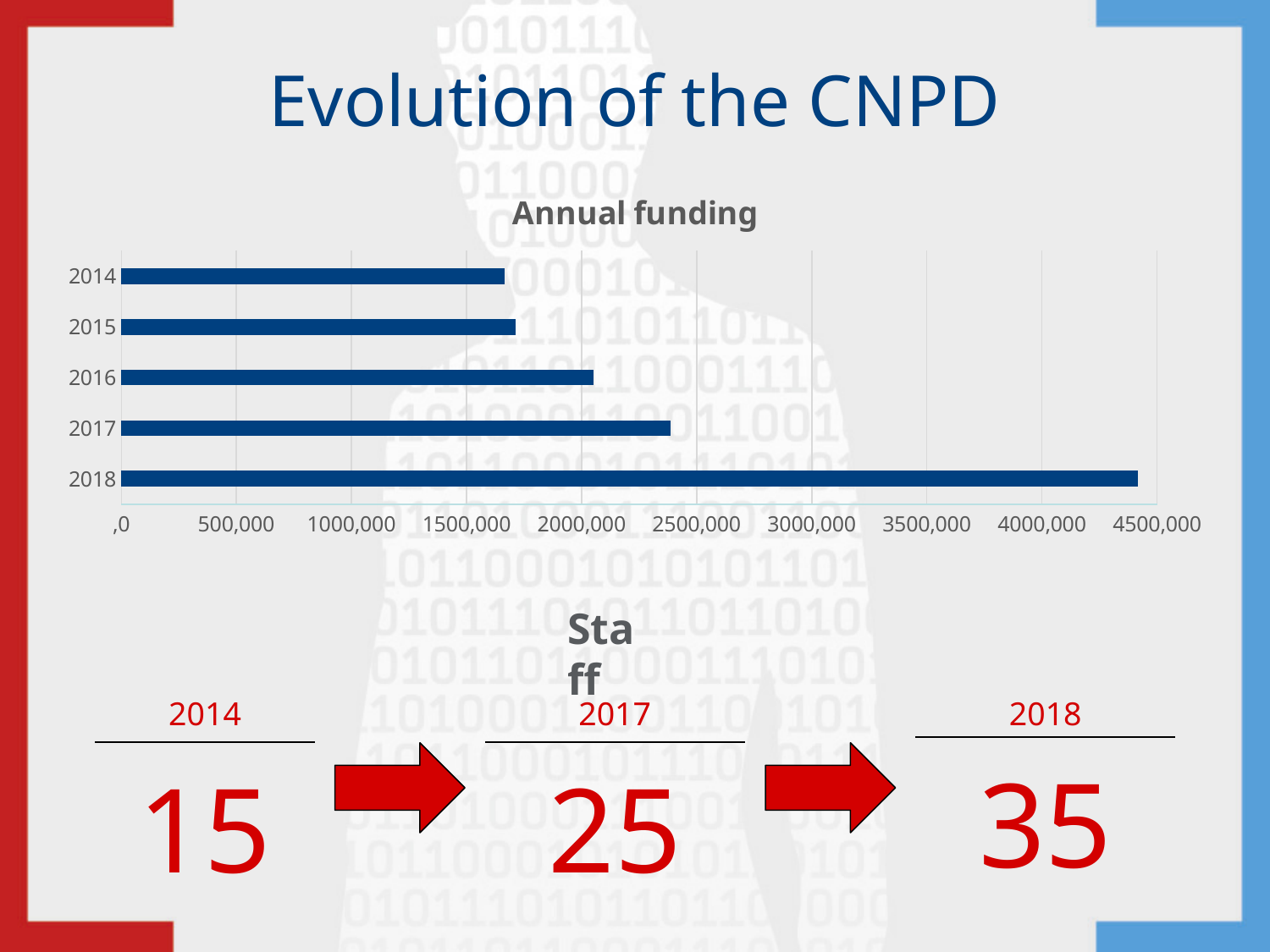
Which year has larger annual funding, 2017 or 2018? 2018 Is the annual funding for 2014 greater or less than 1500,000? greater Is the annual funding for 2015 greater or less than 2000,000? less What is the title of the chart on the slide? Annual funding Does annual funding rise or fall from 2014 to 2018? rise Is the annual funding for 2018 greater or less than 4000,000? greater How many years are shown in the Annual funding chart? 5 Which year has the highest annual funding in the chart? 2018 What kind of chart is the Annual funding chart? bar chart Which year has larger annual funding, 2015 or 2016? 2016